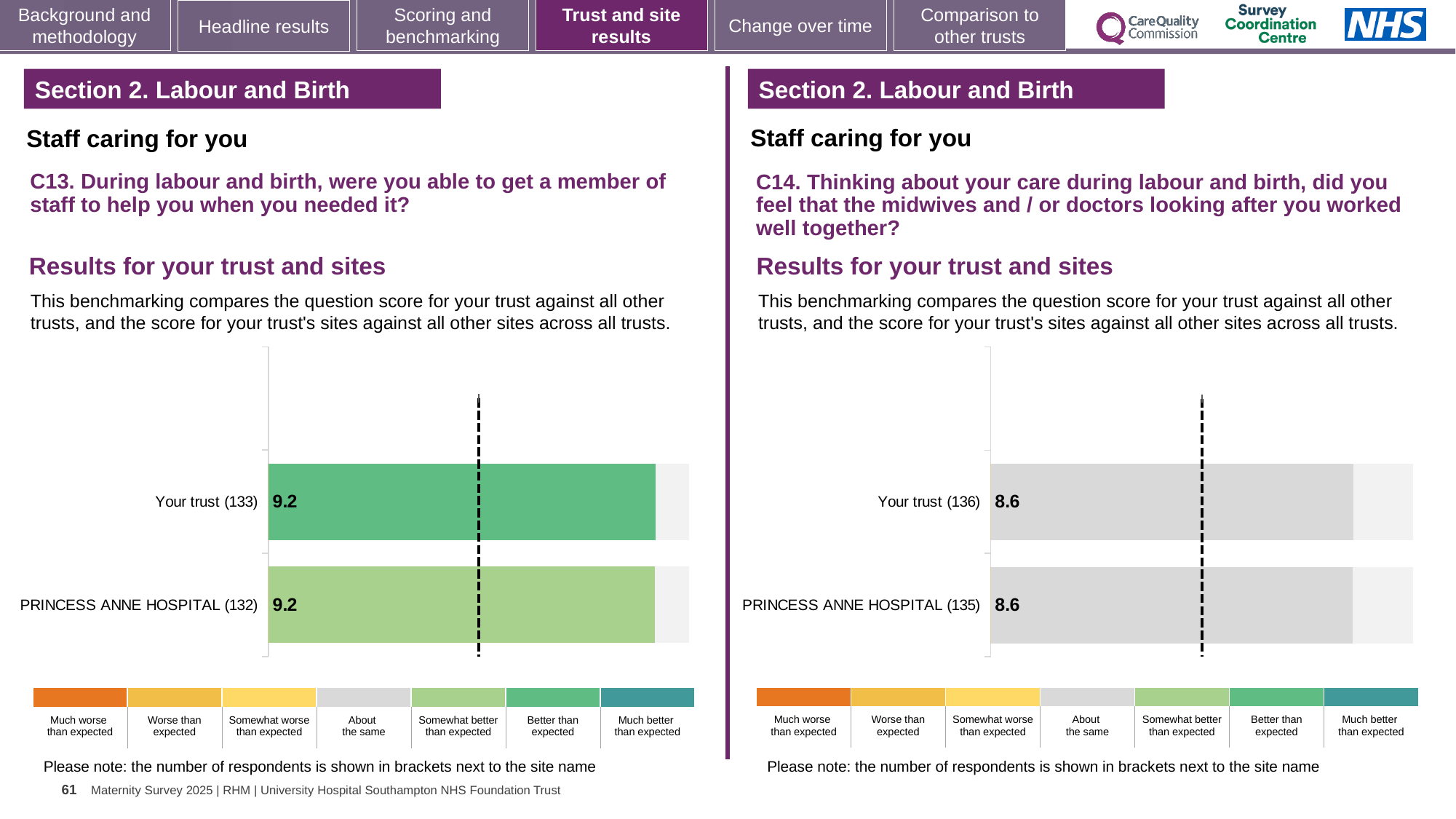
On the C13 chart (left), what is the difference between the score for Your trust and the score for PRINCESS ANNE HOSPITAL? 0 On the C13 chart (left), how many respondents are shown in brackets for PRINCESS ANNE HOSPITAL? 132 What kind of chart is used for the C13 results (left)? Bar chart How many bars are plotted on the C13 chart (left)? 2 On the C14 chart (right), how many respondents are shown in brackets for Your trust? 136 On the C13 chart (left), what is the score for Your trust? 9.2 On the C13 chart (left), what is the score for PRINCESS ANNE HOSPITAL? 9.2 On the C14 chart (right), what is the score for PRINCESS ANNE HOSPITAL? 8.6 How many bars are plotted on the C14 chart (right)? 2 On the C14 chart (right), what is the difference between the score for Your trust and the score for PRINCESS ANNE HOSPITAL? 0 On the C14 chart (right), which benchmark category does the grey colour of the Your trust bar correspond to in the legend? About the same On the C14 chart (right), what is the score for Your trust? 8.6